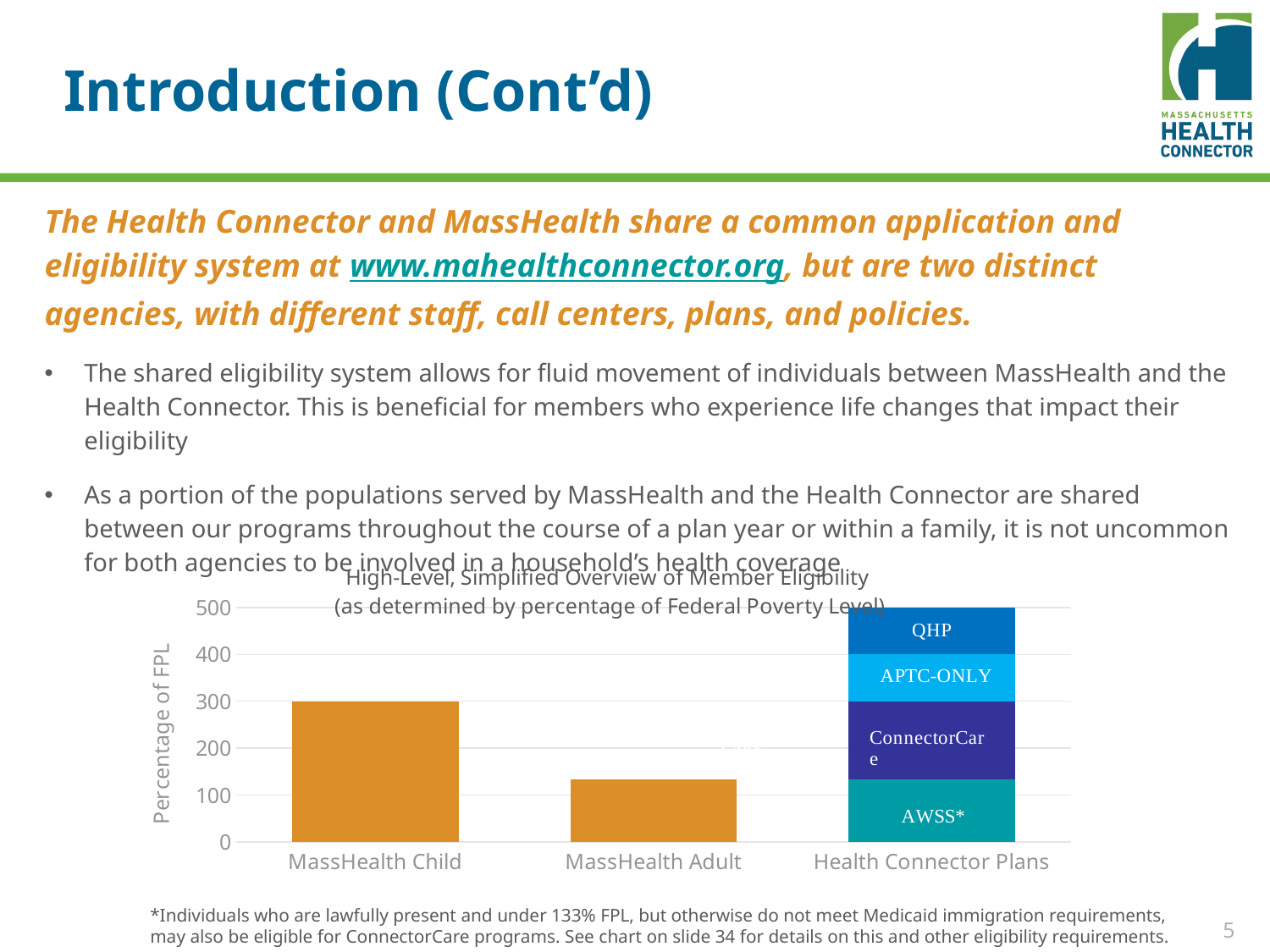
Is the top of the Health Connector Plans bar greater or less than 400? greater Which is larger, the bar for MassHealth Child or the bar for MassHealth Adult? MassHealth Child Which category has the shortest bar in the chart? MassHealth Adult Is the value for MassHealth Child greater or less than 200? greater What is the label of the y axis of the chart? Percentage of FPL How many categories are shown on the x axis of the chart? 3 Which segment is at the bottom of the stacked bar for Health Connector Plans? AWSS* How many segments make up the stacked bar for Health Connector Plans? 4 Is the value for MassHealth Adult greater or less than 200? less Which category has the tallest bar in the chart? Health Connector Plans What type of chart is shown on the slide? bar chart